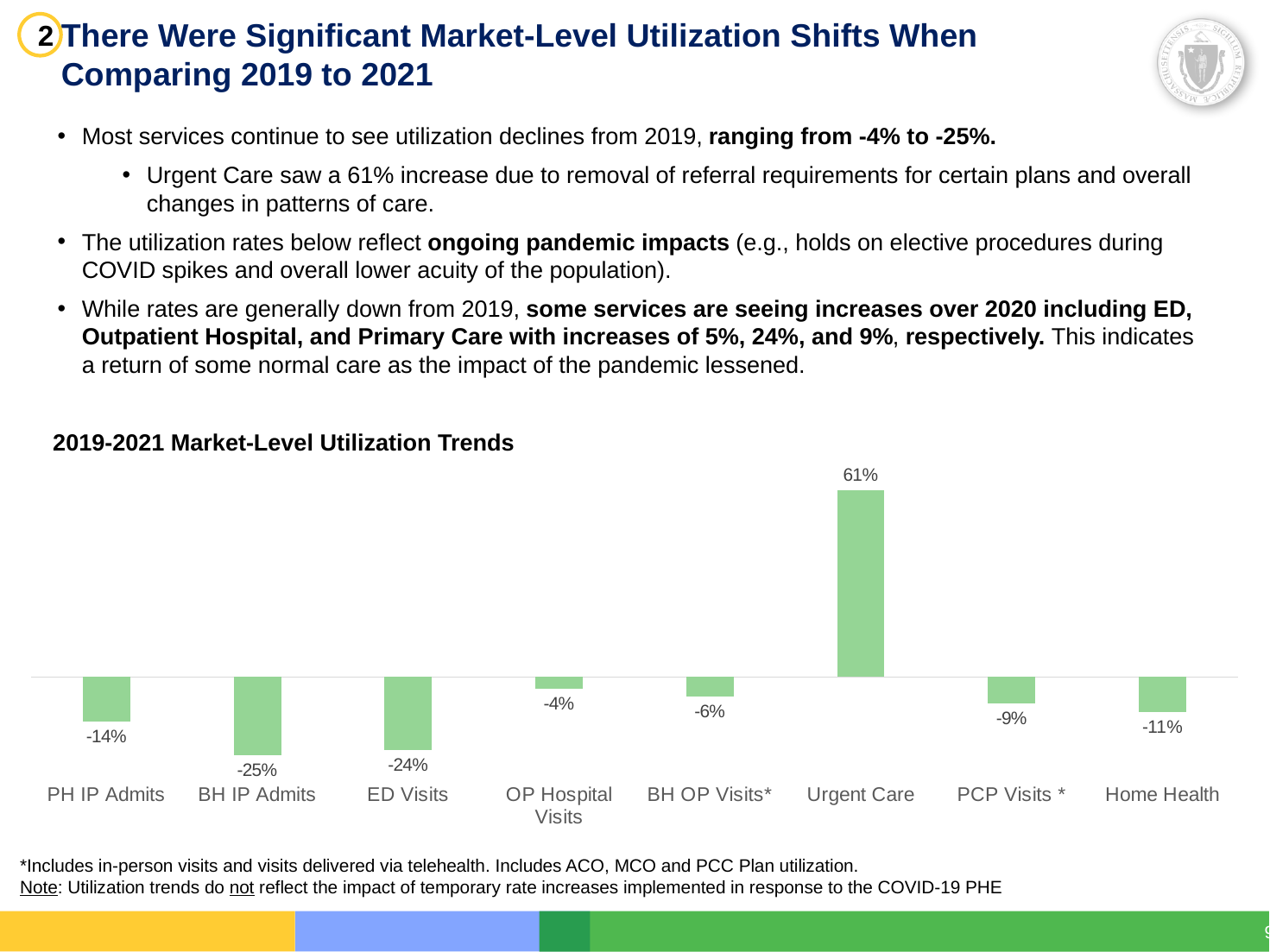
Which category has the lowest value? BH IP Admits What is the value for BH IP Admits? -25% Which is larger, the value for PCP Visits * or the value for BH OP Visits*? BH OP Visits* What is the value for Home Health? -11% How many categories are shown in the chart? 8 What kind of chart is shown on the slide? Bar chart What is the value for OP Hospital Visits? -4% Which category has the highest value? Urgent Care What is the value for Urgent Care in the 2019-2021 Market-Level Utilization Trends chart? 61% What is the difference between the values for ED Visits and PH IP Admits? 10 percentage points What is the title of the chart? 2019-2021 Market-Level Utilization Trends How many categories in the chart have a negative value? 7